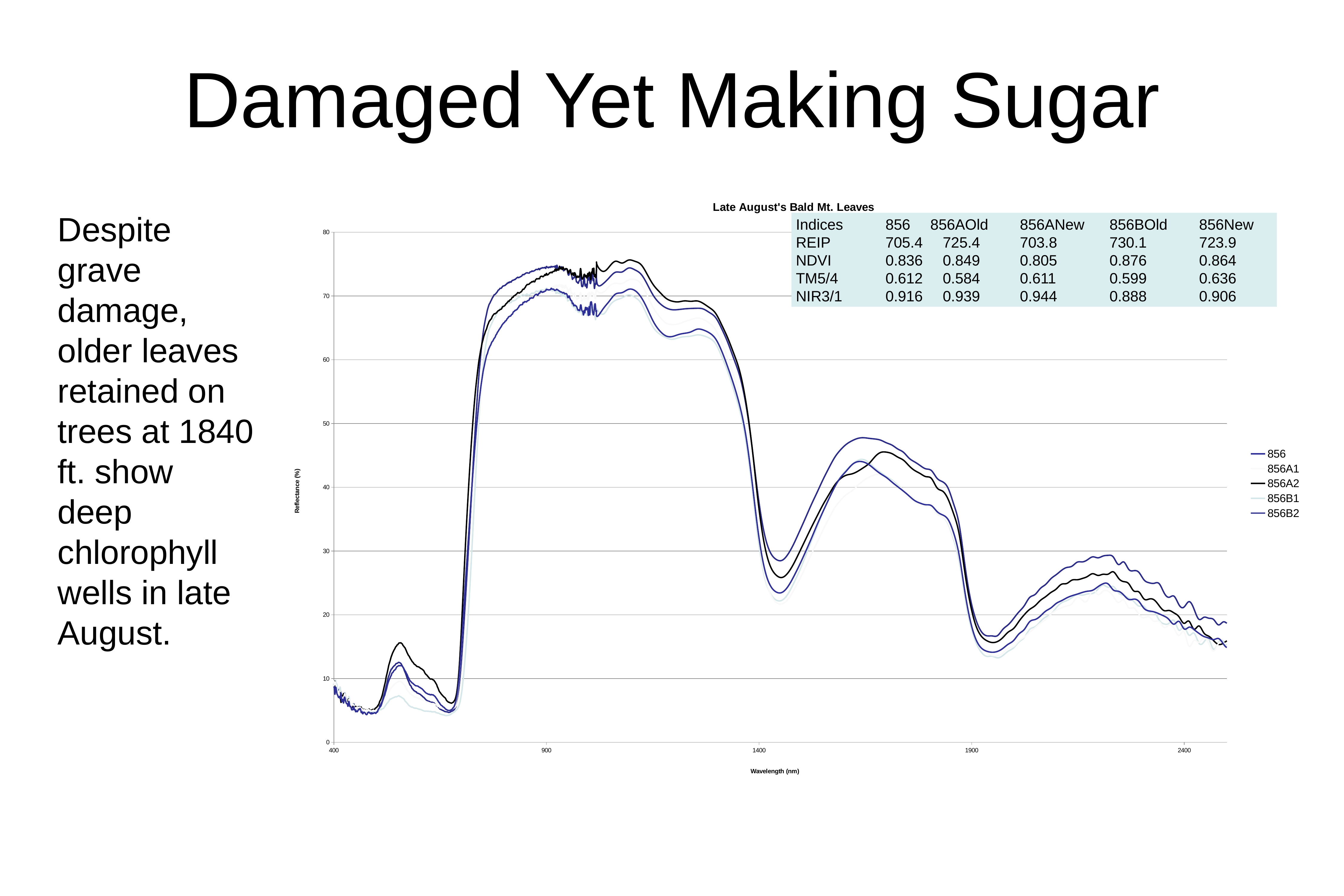
What is the label of the x axis of the chart? Wavelength (nm) What is the highest value shown on the y axis of the chart? 80 How many series does the legend of the chart list? 5 What kind of chart is shown on the slide? line chart Is the reflectance of the 856A2 series at 900 nm greater or less than 60? greater Is the peak reflectance of the 856 series between 1400 nm and 1900 nm greater or less than 40? greater Is the reflectance of the 856A2 series at 1900 nm greater or less than 30? less Do the reflectance values rise or fall along the x axis between 400 nm and 900 nm? rise Do the reflectance values rise or fall along the x axis between 1100 nm and 1400 nm? fall What is the title of the chart? Late August's Bald Mt. Leaves